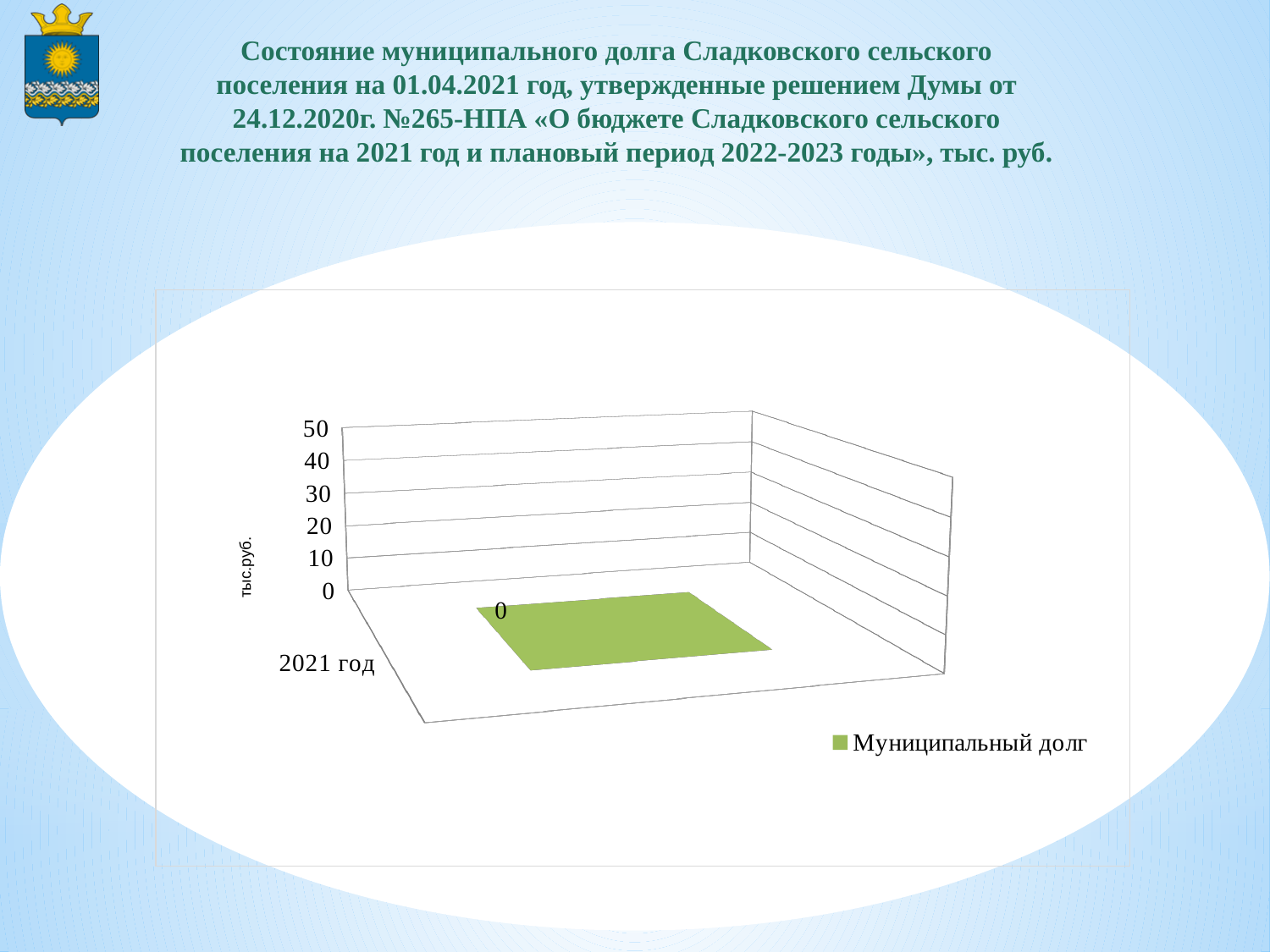
How many categories are shown on the x axis of the chart? 1 What is the value of Муниципальный долг for 2021 год? 0 What series name is shown in the chart legend? Муниципальный долг Which category is shown on the x axis of the chart? 2021 год How many series does the chart legend list? 1 Is the value for 2021 год greater or less than 10? less What is the highest tick value shown on the vertical axis? 50 What is the label on the vertical axis of the chart? тыс.руб. What kind of chart is shown on the slide? bar chart